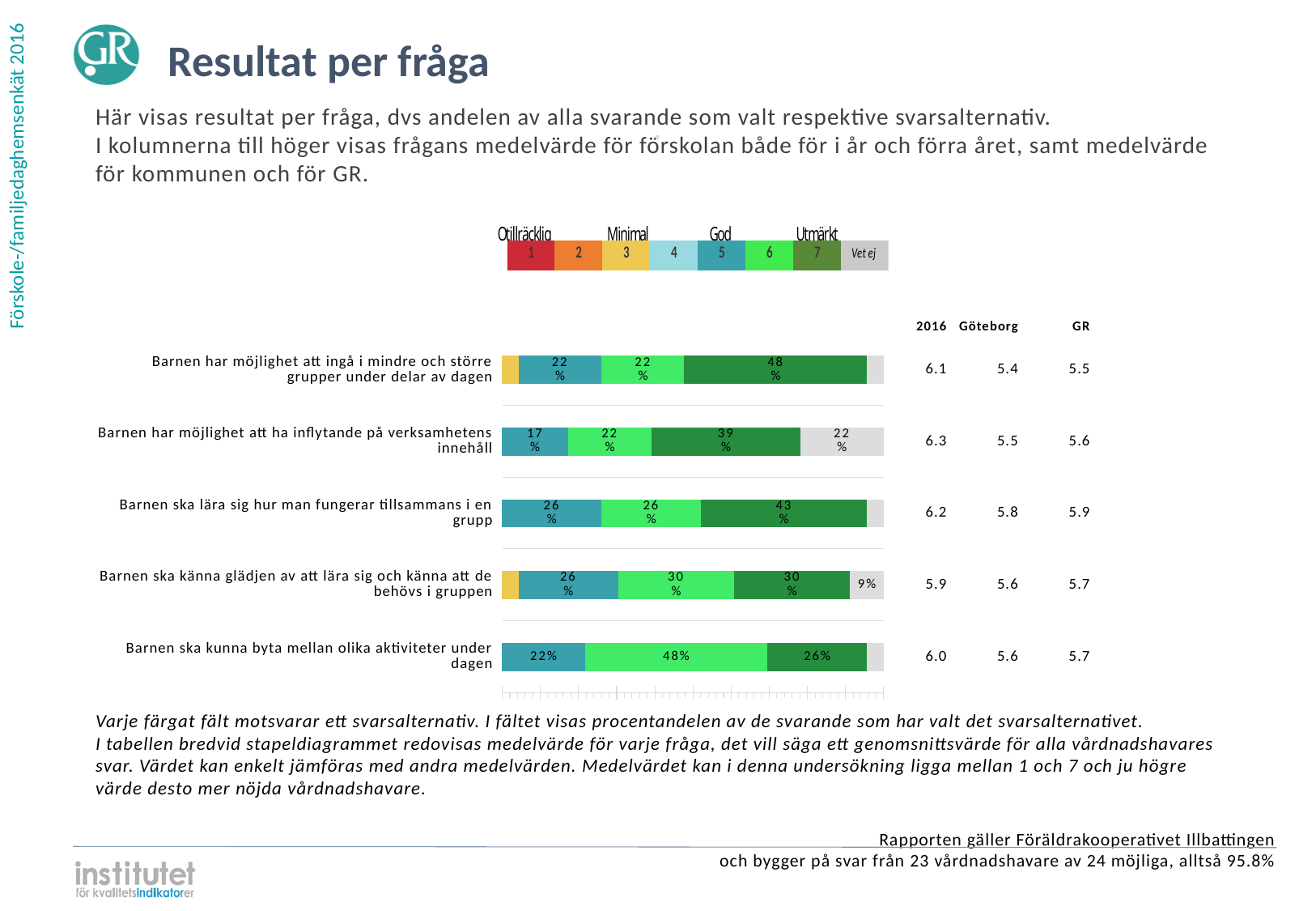
What is the GR mean value shown for "Barnen ska kunna byta mellan olika aktiviteter under dagen"? 5.7 What is the 2016 mean value shown for "Barnen ska lära sig hur man fungerar tillsammans i en grupp"? 6.2 For "Barnen ska känna glädjen av att lära sig och känna att de behövs i gruppen", which is larger: the share for answer 5 or the share for answer 6? Answer 6 Which question has the lowest 2016 mean value in the table? Barnen ska känna glädjen av att lära sig och känna att de behövs i gruppen What percentage of respondents chose answer 7 for "Barnen har möjlighet att ingå i mindre och större grupper under delar av dagen"? 48% What is the difference between the answer 7 share and the answer 5 share for "Barnen ska lära sig hur man fungerar tillsammans i en grupp"? 17% How many entries does the legend above the chart list? 8 How many questions (bars) are plotted in the chart? 5 Which question has the highest 2016 mean value in the table? Barnen har möjlighet att ha inflytande på verksamhetens innehåll What kind of chart is shown on the slide? Stacked bar chart What percentage chose answer 6 for "Barnen ska kunna byta mellan olika aktiviteter under dagen"? 48% What percentage chose "Vet ej" for "Barnen har möjlighet att ha inflytande på verksamhetens innehåll"? 22%